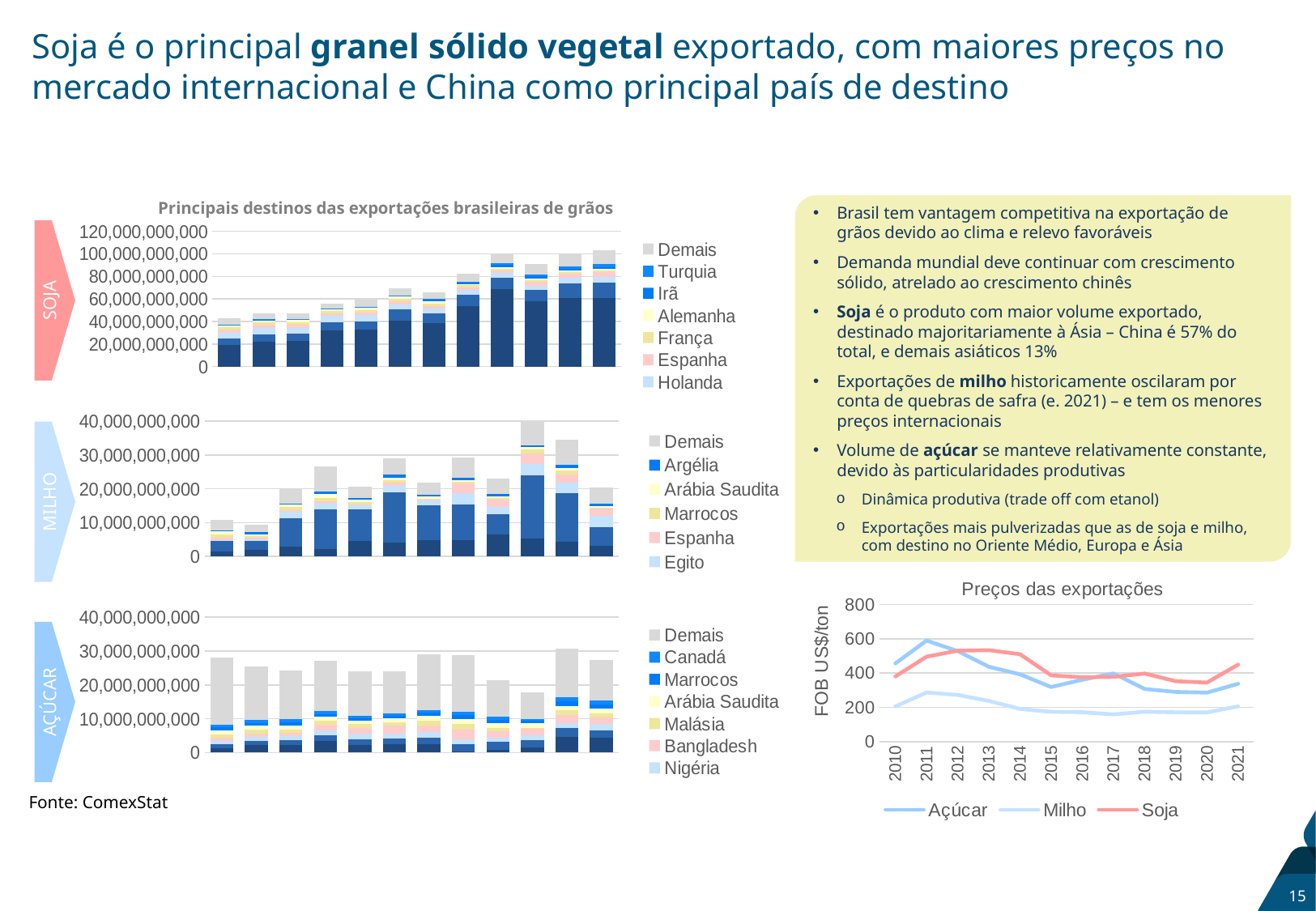
In the 'Preços das exportações' chart, how many series does the legend list? 3 In the 'Preços das exportações' chart, in which year is the Açúcar price highest? 2011 In the MILHO chart, how many entries does the legend list? 6 In the 'Preços das exportações' chart, in which year is the Milho price highest? 2011 What kind of chart is the 'Preços das exportações' chart? line chart In the 'Preços das exportações' chart, is the Milho value for 2017 greater or less than 200? less What is the y-axis label of the 'Preços das exportações' chart? FOB US$/ton What kind of chart is the SOJA chart on the left? bar chart In the 'Preços das exportações' chart, which is higher in 2021, Soja or Açúcar? Soja In the 'Preços das exportações' chart, does the Milho price rise or fall from 2011 to 2017? fall In the 'Preços das exportações' chart, how many years are shown on the x axis? 12 In the 'Preços das exportações' chart, is the Açúcar value for 2011 greater or less than 400? greater